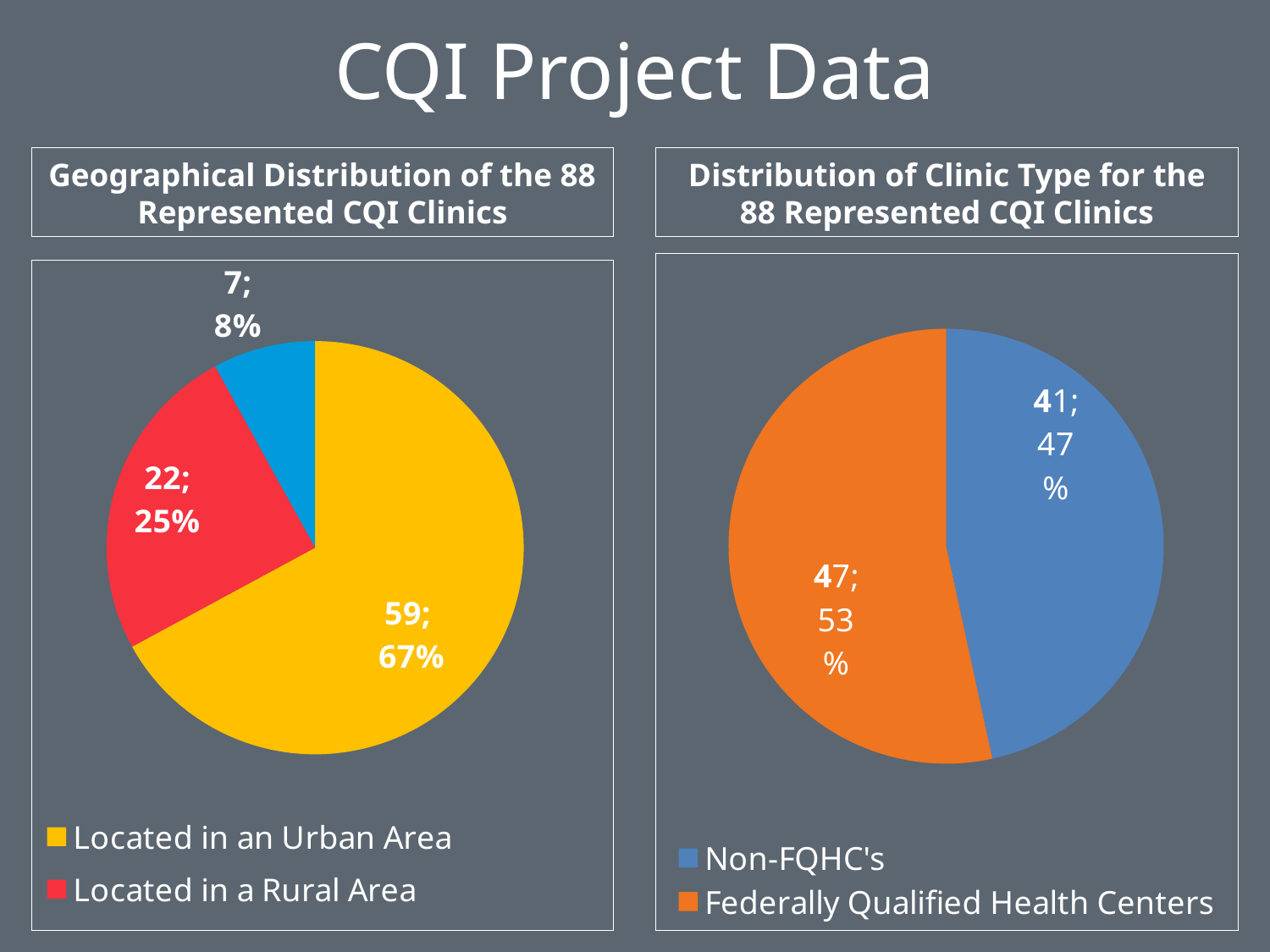
What type of chart is used on the right side of the slide for 'Distribution of Clinic Type for the 88 Represented CQI Clinics'? Pie chart On the 'Geographical Distribution of the 88 Represented CQI Clinics' chart, how many entries does the legend list? 2 On the 'Distribution of Clinic Type for the 88 Represented CQI Clinics' chart, what is the difference in the number of clinics between Federally Qualified Health Centers and Non-FQHC's? 6 On the 'Geographical Distribution of the 88 Represented CQI Clinics' chart, how many clinics are located in an urban area? 59 On the 'Geographical Distribution of the 88 Represented CQI Clinics' chart, which category has the largest slice? Located in an Urban Area On the 'Geographical Distribution of the 88 Represented CQI Clinics' chart, how many more clinics are in an urban area than in a rural area? 37 On the 'Distribution of Clinic Type for the 88 Represented CQI Clinics' chart, how many clinics are Federally Qualified Health Centers? 47 On the 'Distribution of Clinic Type for the 88 Represented CQI Clinics' chart, what colour represents Non-FQHC's? Blue On the 'Distribution of Clinic Type for the 88 Represented CQI Clinics' chart, what percentage of clinics are Non-FQHC's? 47% On the 'Geographical Distribution of the 88 Represented CQI Clinics' chart, what percentage of clinics are located in a rural area? 25% On the 'Geographical Distribution of the 88 Represented CQI Clinics' chart, how many slices does the pie have? 3 On the 'Distribution of Clinic Type for the 88 Represented CQI Clinics' chart, which clinic type has the larger share? Federally Qualified Health Centers